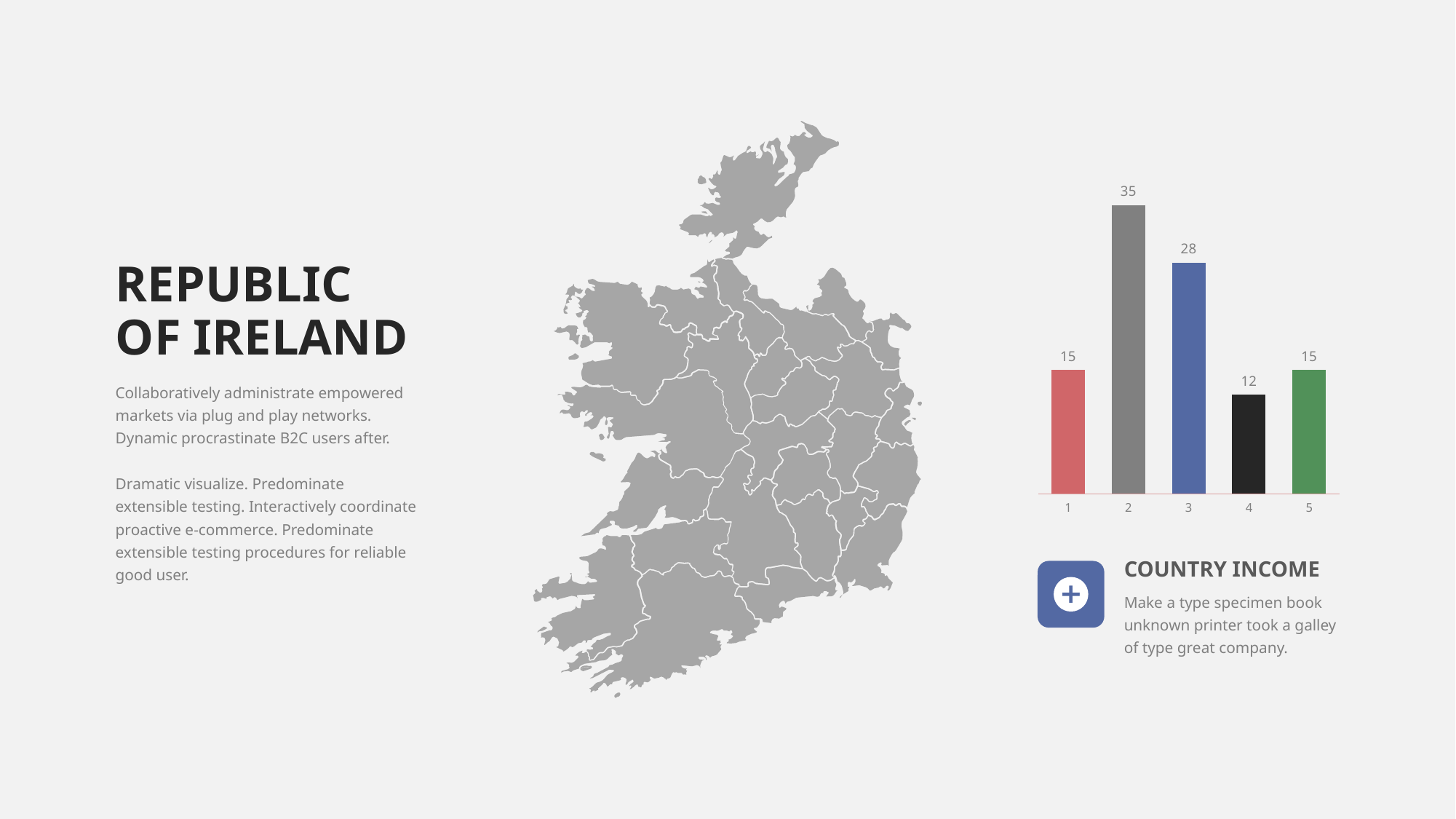
Which is larger, the value for category 3 or the value for category 5? category 3 What is the value of the bar for category 2? 35 What kind of chart is shown on the slide? bar chart What colour is the bar for category 3? blue What is the difference between the values for category 2 and category 3? 7 Which category has the lowest bar? 4 Which category has the highest bar? 2 What is the value of the bar for category 4? 12 What is the value of the bar for category 3? 28 How many bars are in the chart? 5 Which two categories have the same value? 1 and 5 What is the difference between the values for category 1 and category 4? 3